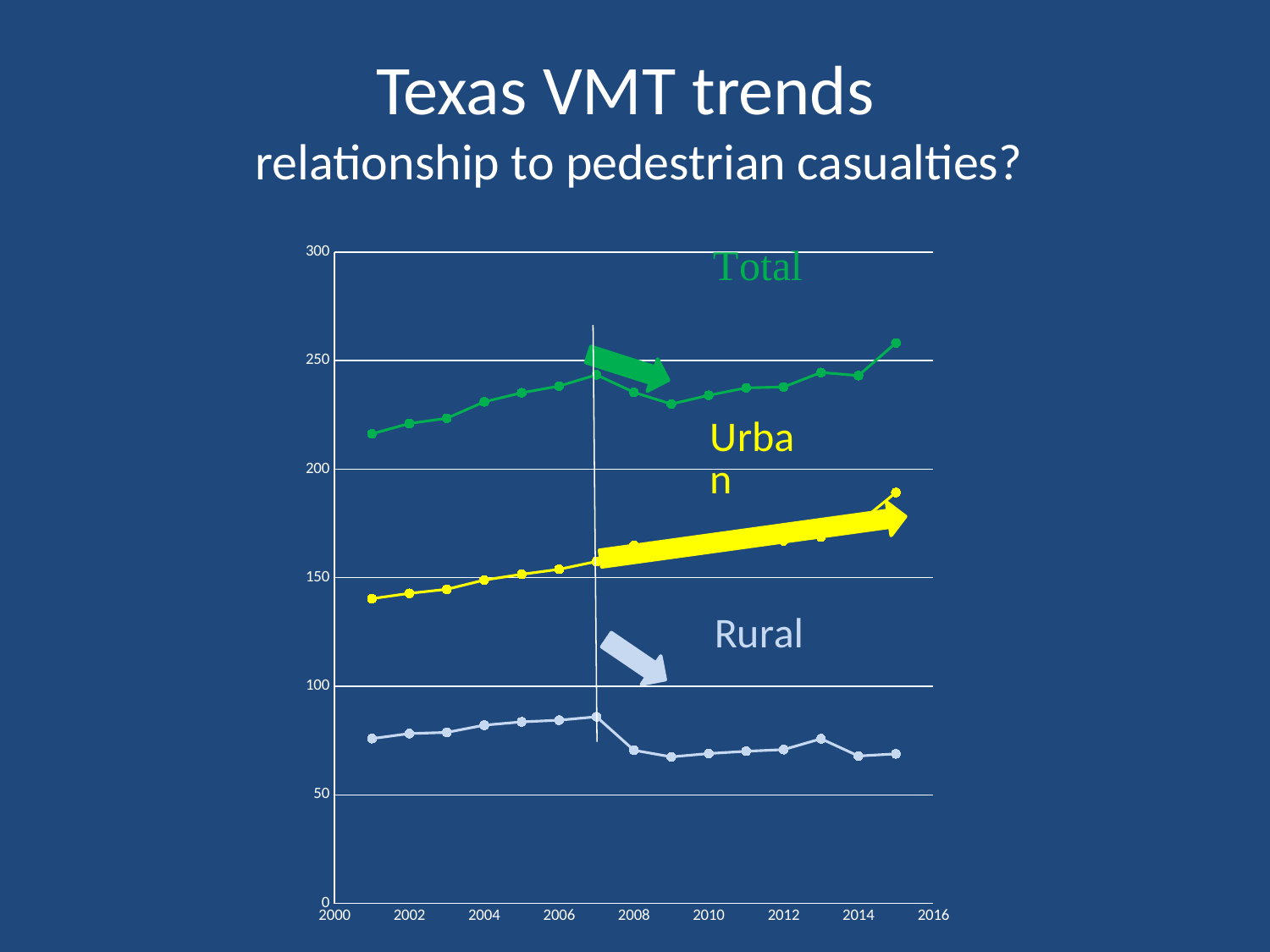
Does the Rural series rise or fall between 2007 and 2009? fall Is the Urban value for 2015 greater or less than 200? less Which series has the highest values throughout the chart? Total Does the Urban series rise or fall from 2001 to 2015? rise How many series are plotted on the chart? 3 Is the Total value for 2015 greater or less than 250? greater In 2010, which is larger, the Total value or the Rural value? Total What is the main title of the slide? Texas VMT trends Is the Rural value for 2007 greater or less than 100? less What kind of chart is shown on the slide? line chart Which series has the lowest values throughout the chart? Rural